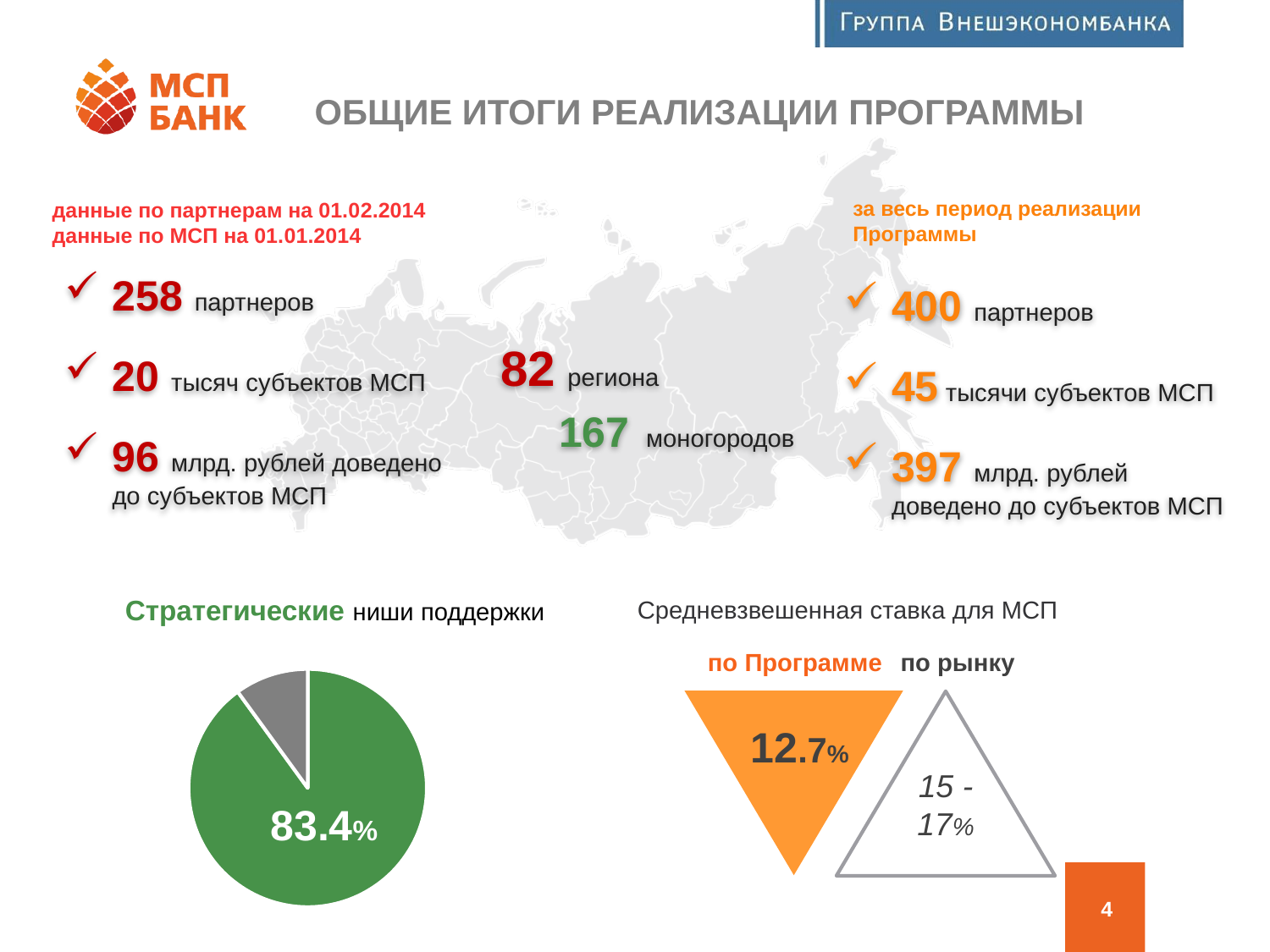
What kind of chart is shown under the heading "Стратегические ниши поддержки"? pie chart In the pie chart "Стратегические ниши поддержки", which slice is the smallest? the grey slice In the pie chart "Стратегические ниши поддержки", which slice is the largest? the green slice (83.4%) What colour is the slice labelled 83.4% in the pie chart? green In the pie chart "Стратегические ниши поддержки", is the green slice larger or smaller than the grey slice? larger What is the title above the pie chart on the slide? Стратегические ниши поддержки In the pie chart "Стратегические ниши поддержки", what share is printed on the green slice? 83.4% How many slices does the pie chart "Стратегические ниши поддержки" have? 2